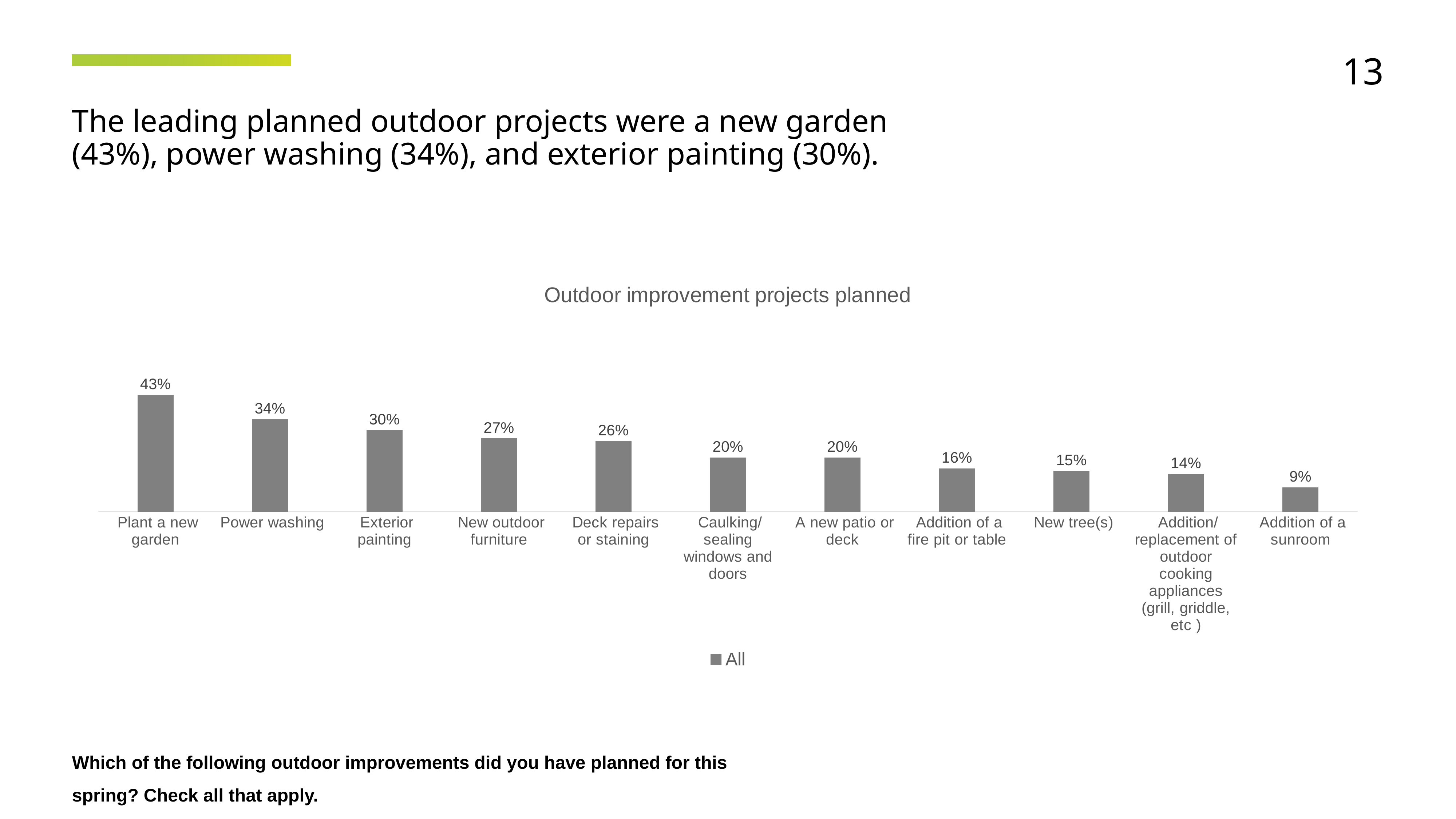
Do the values rise or fall from left to right across the categories? Fall What is the value for Addition of a fire pit or table? 16% Which category has the highest value? Plant a new garden What is the difference between the values for Plant a new garden and Exterior painting? 13% Which category has the lowest value? Addition of a sunroom How many categories are shown in the chart? 11 Which is larger, the value for New outdoor furniture or the value for New tree(s)? New outdoor furniture What is the title of the chart? Outdoor improvement projects planned What kind of chart is shown on the slide? Bar chart What is the value for Deck repairs or staining? 26% What is the value for Power washing? 34% How many series does the legend list? 1